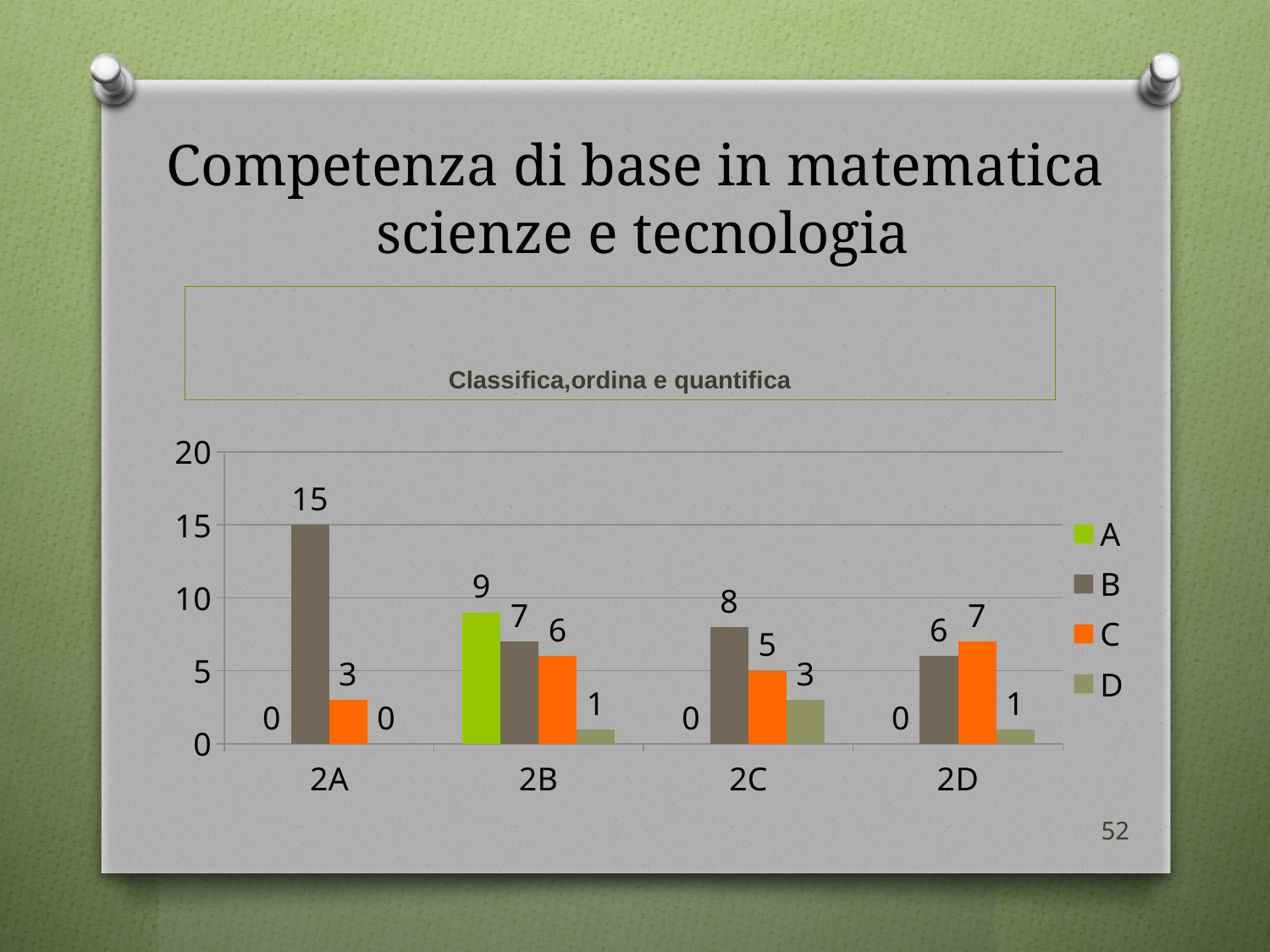
How many categories are shown on the x axis? 4 What is the value of series B for category 2A? 15 What is the value of series C for category 2D? 7 What is the value of series D for category 2C? 3 What type of chart is shown on the slide? bar chart For category 2D, which is larger: series B or series C? C Is the value of series B for 2A greater or less than 10? greater What is the difference between the series B value for 2A and the series B value for 2C? 7 What is the value of series A for category 2B? 9 Which category has the lowest value for series C? 2A How many series does the legend list? 4 Which category has the highest value for series B? 2A